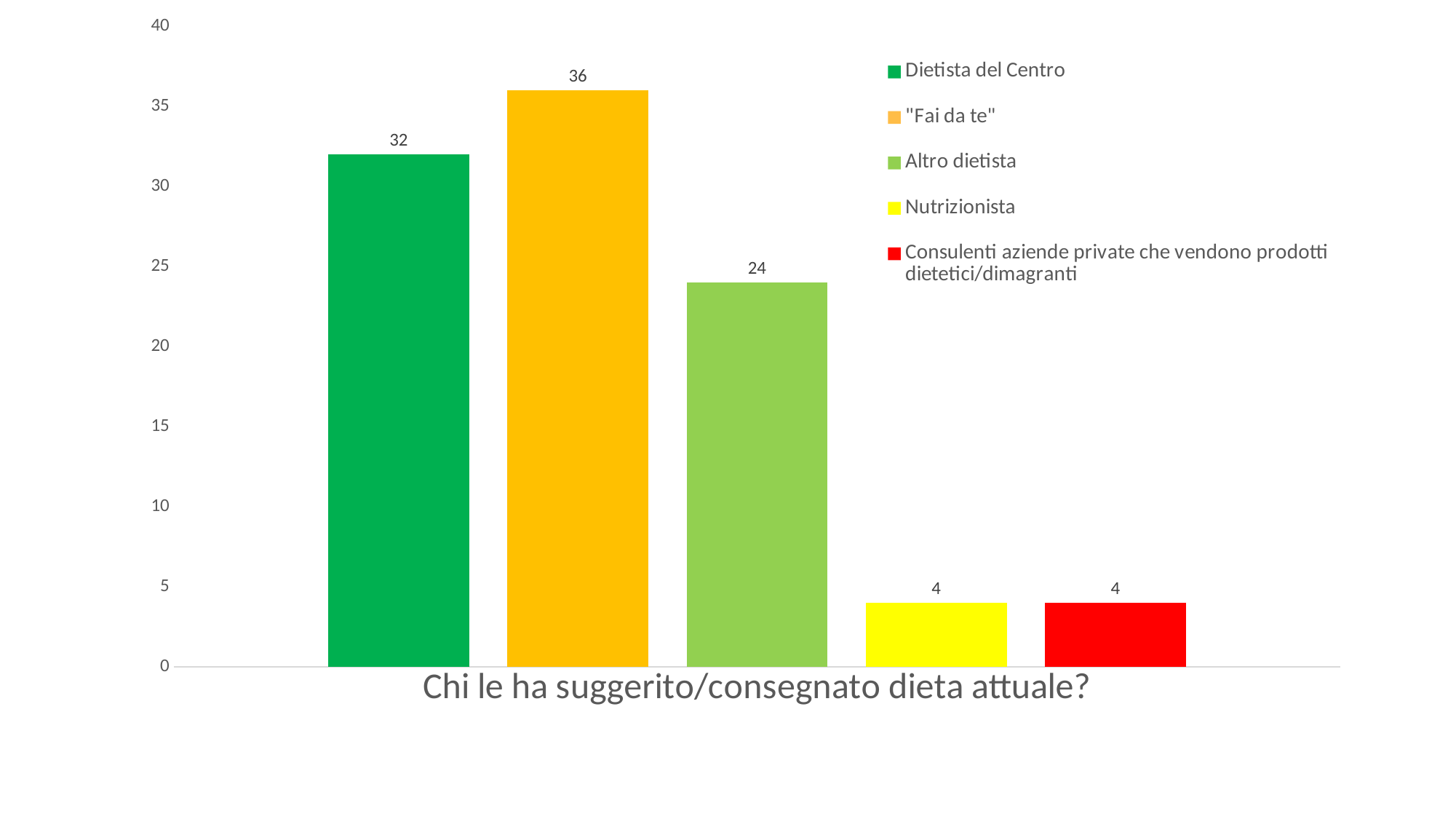
What is the value for Altro dietista? 24 Which category has the highest value? "Fai da te" What is the value for Nutrizionista? 4 What is the value for "Fai da te"? 36 What is the difference between the values for "Fai da te" and Dietista del Centro? 4 Is the value for Altro dietista greater or less than 20? greater Which is larger, the value for Dietista del Centro or the value for Altro dietista? Dietista del Centro How many bars are shown in the chart? 5 What is the difference between the values for Dietista del Centro and Altro dietista? 8 What is the title shown below the chart? Chi le ha suggerito/consegnato dieta attuale? What is the value for Dietista del Centro? 32 What kind of chart is shown on the slide? Bar chart